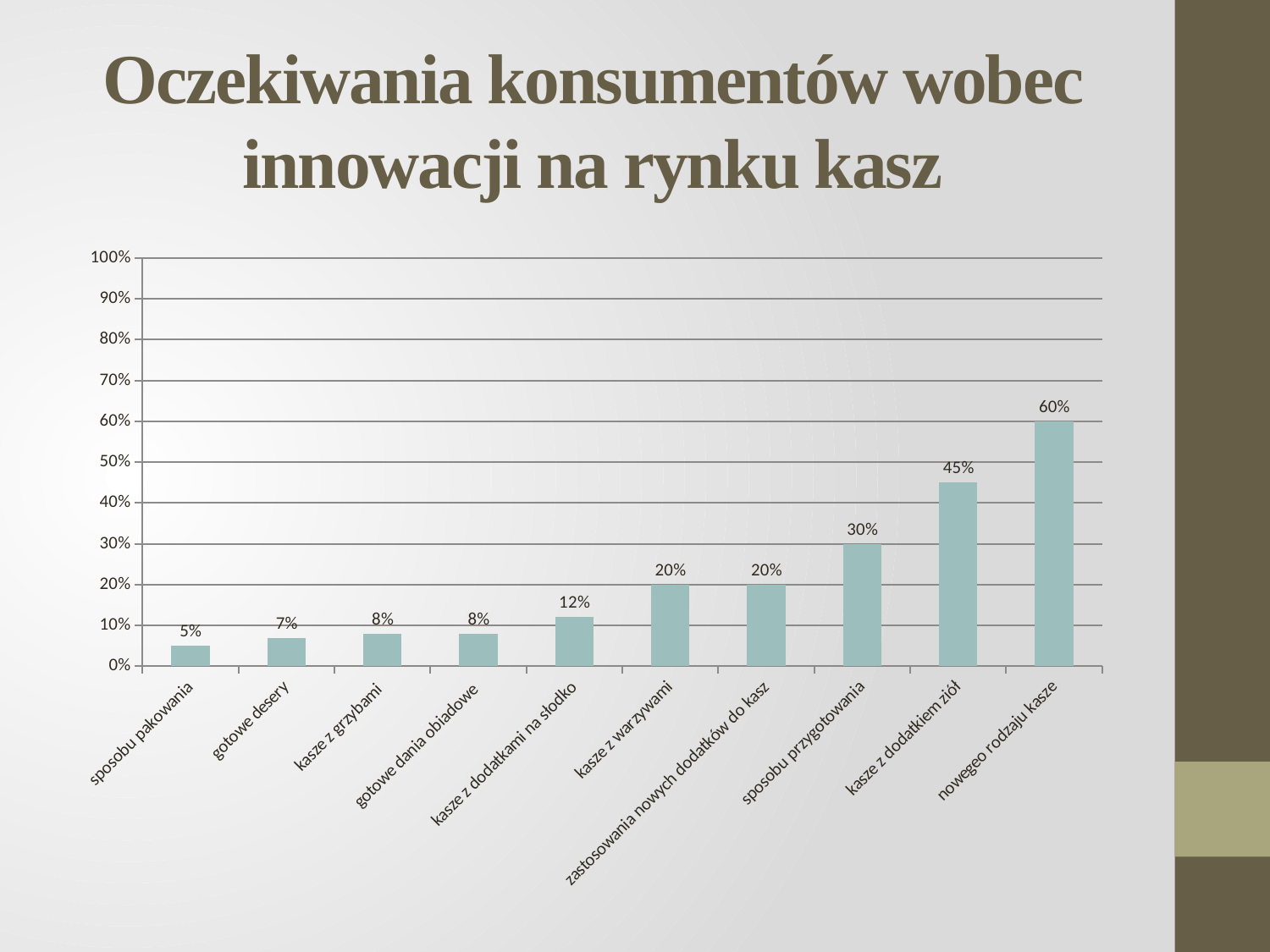
What is the value for 'nowegeo rodzaju kasze'? 60% Do the values rise or fall from left to right along the x axis? rise What kind of chart is shown on the slide? bar chart What is the value for 'sposobu przygotowania'? 30% How many categories are shown on the x axis? 10 Is the value for 'kasze z dodatkiem ziół' greater or less than 40%? greater What is the difference between the values for 'nowegeo rodzaju kasze' and 'kasze z dodatkiem ziół'? 15% What is the value for 'kasze z dodatkami na słodko'? 12% Which is larger, the value for 'gotowe desery' or the value for 'kasze z dodatkami na słodko'? kasze z dodatkami na słodko Which category has the highest value? nowegeo rodzaju kasze Which category has the lowest value? sposobu pakowania What is the difference between the values for 'sposobu przygotowania' and 'kasze z warzywami'? 10%